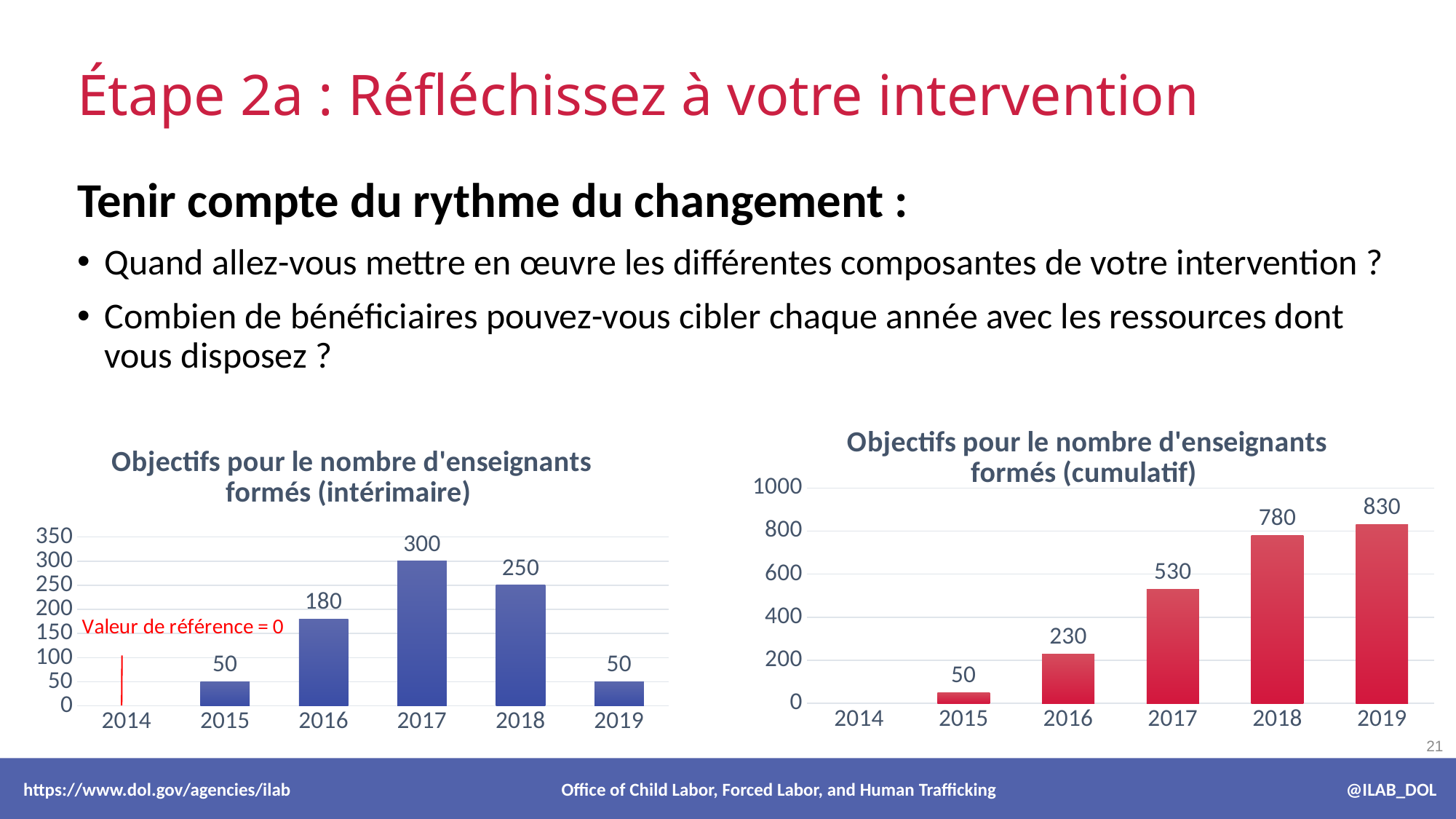
In the chart titled 'Objectifs pour le nombre d'enseignants formés (cumulatif)', what is the value for 2017? 530 In the chart titled 'Objectifs pour le nombre d'enseignants formés (intérimaire)', what is the reference value (valeur de référence) shown for 2014? 0 In the chart titled 'Objectifs pour le nombre d'enseignants formés (intérimaire)', which year has the highest value? 2017 In the chart titled 'Objectifs pour le nombre d'enseignants formés (cumulatif)', is the value for 2018 larger or smaller than the value for 2017? larger In the chart titled 'Objectifs pour le nombre d'enseignants formés (cumulatif)', do the values rise or fall from 2015 to 2019? rise In the chart titled 'Objectifs pour le nombre d'enseignants formés (intérimaire)', what is the value for 2017? 300 In the chart titled 'Objectifs pour le nombre d'enseignants formés (cumulatif)', which year has the lowest non-zero value? 2015 In the chart titled 'Objectifs pour le nombre d'enseignants formés (cumulatif)', what is the difference between the values for 2018 and 2016? 550 What kind of chart is the chart on the right of the slide? bar chart In the chart titled 'Objectifs pour le nombre d'enseignants formés (intérimaire)', what is the difference between the values for 2017 and 2018? 50 In the chart titled 'Objectifs pour le nombre d'enseignants formés (intérimaire)', what is the value for 2016? 180 In the chart titled 'Objectifs pour le nombre d'enseignants formés (cumulatif)', what is the value for 2019? 830